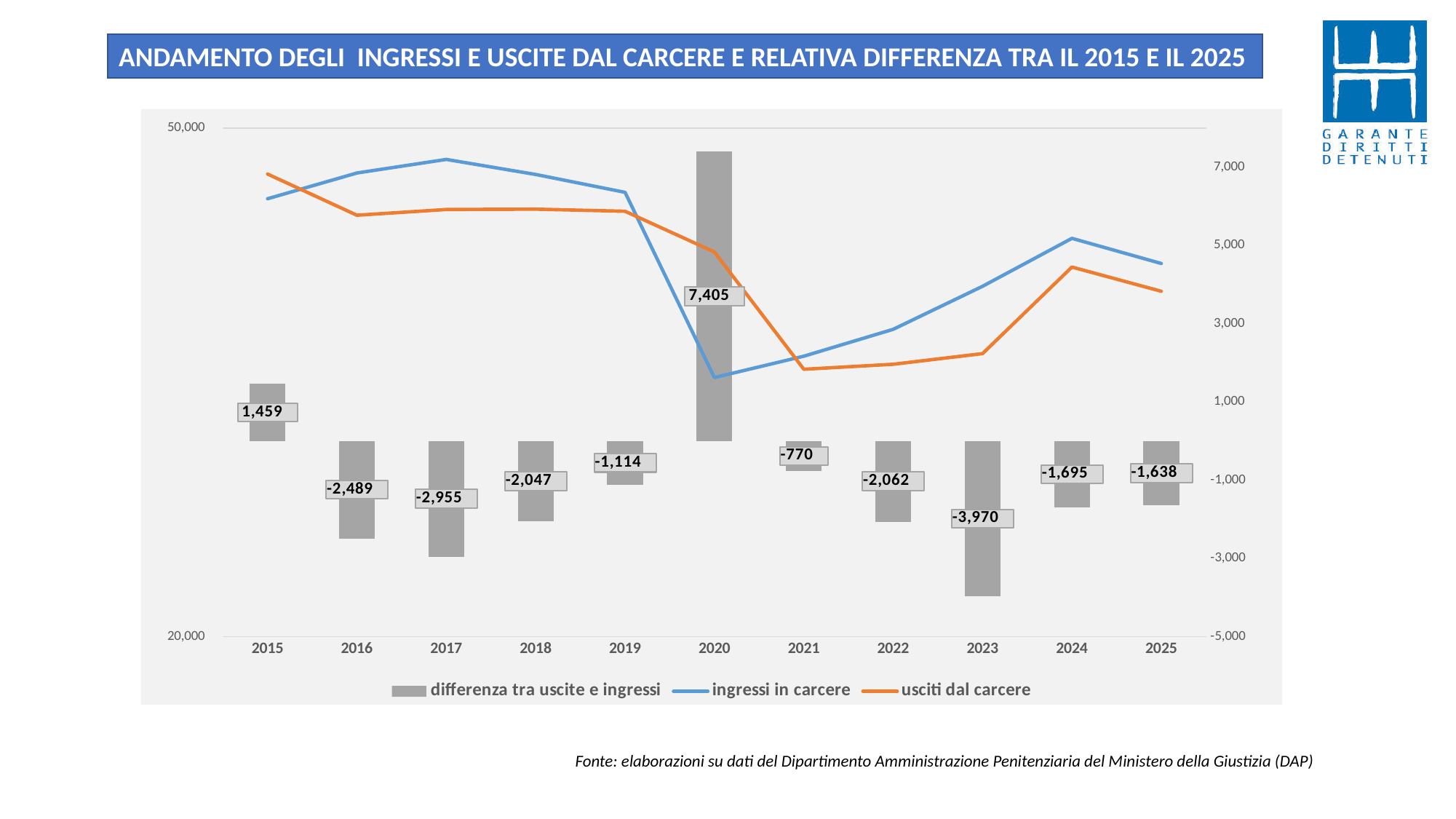
How many years are shown on the x axis? 11 What is the value of 'differenza tra uscite e ingressi' for 2021? -770 What is the value of 'differenza tra uscite e ingressi' for 2015? 1,459 Which series is drawn in orange? usciti dal carcere In 2020, which line is higher, 'ingressi in carcere' or 'usciti dal carcere'? usciti dal carcere What is the value of 'differenza tra uscite e ingressi' for 2020? 7,405 Which year has a larger 'differenza tra uscite e ingressi' value, 2018 or 2019? 2019 In which year is the 'differenza tra uscite e ingressi' bar lowest? 2023 What is the difference between the 'differenza tra uscite e ingressi' values for 2017 and 2016? 466 What is the value of 'differenza tra uscite e ingressi' for 2023? -3,970 In which year is the 'differenza tra uscite e ingressi' bar highest? 2020 How many series does the legend list? 3